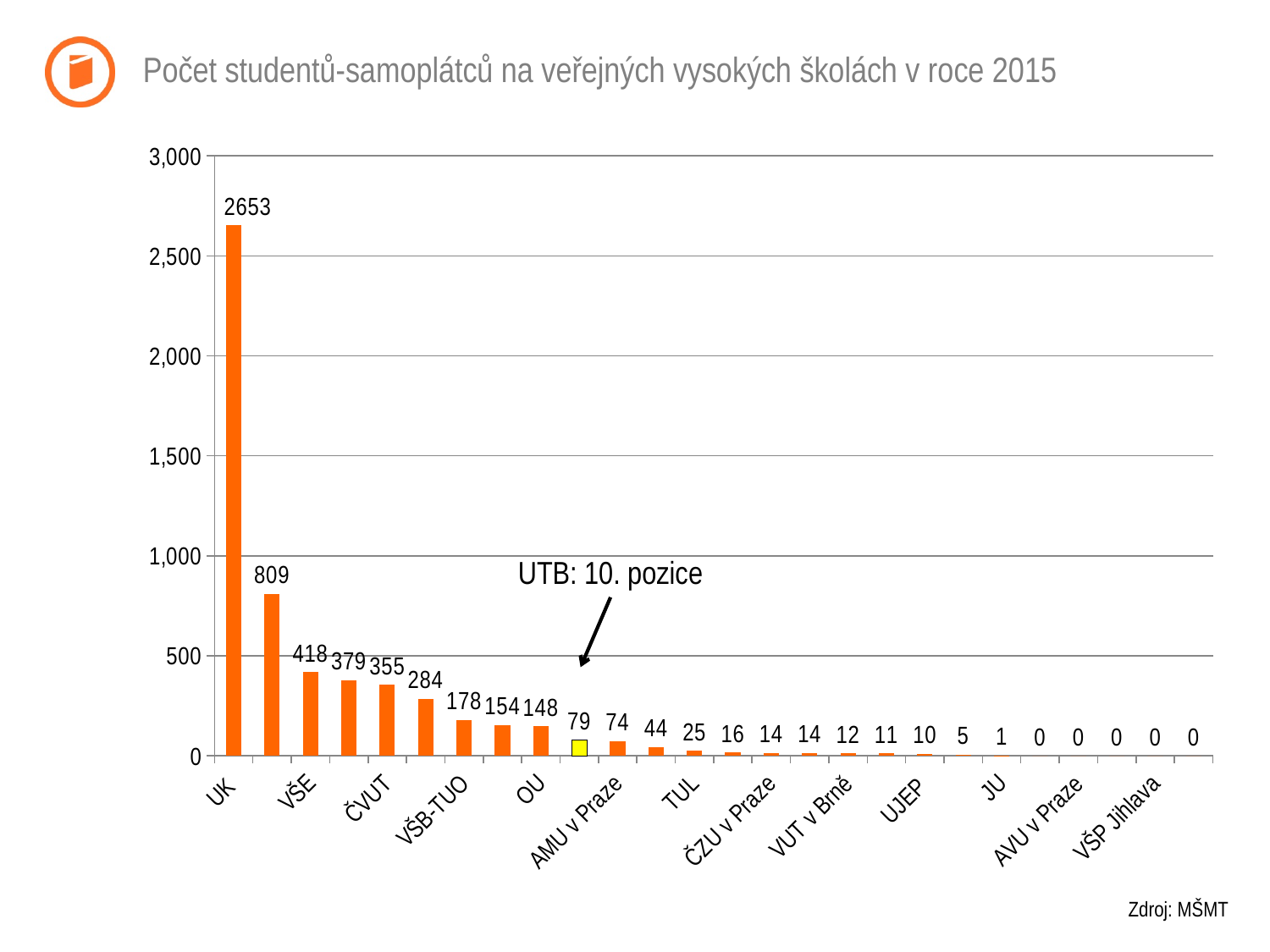
How many bars are plotted in the chart? 26 What is the value for VŠE? 418 What is the value for UK? 2653 What is the value of the highlighted (yellow) bar for UTB? 79 Is the value for VŠE larger or smaller than the value for UK? smaller Which university has the highest number of self-paying students? UK What is the difference between the highest bar (2653) and the second highest bar (809)? 1844 What kind of chart is shown on the slide? bar chart Which position does UTB hold according to the annotation on the chart? 10. pozice Do the values rise or fall from left to right along the x axis? fall Is the value for UK greater or less than 2,500? greater What is the title of the chart? Počet studentů-samoplátců na veřejných vysokých školách v roce 2015